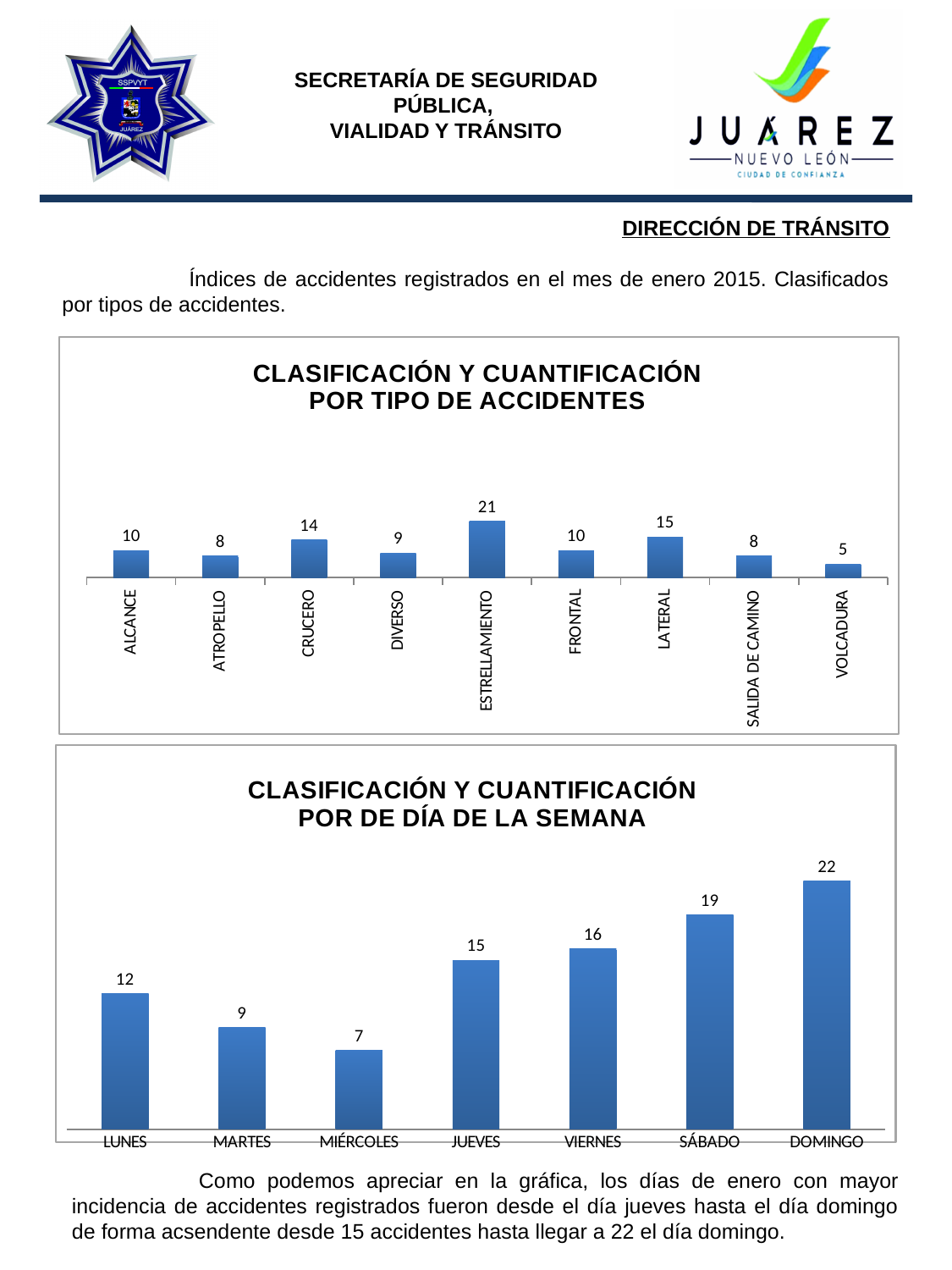
In the chart 'CLASIFICACIÓN Y CUANTIFICACIÓN POR DE DÍA DE LA SEMANA', do the values rise or fall from JUEVES to DOMINGO? rise What kind of chart is 'CLASIFICACIÓN Y CUANTIFICACIÓN POR DE DÍA DE LA SEMANA'? bar chart In the chart 'CLASIFICACIÓN Y CUANTIFICACIÓN POR DE DÍA DE LA SEMANA', what is the difference between DOMINGO and LUNES? 10 In the chart 'CLASIFICACIÓN Y CUANTIFICACIÓN POR TIPO DE ACCIDENTES', which category has the highest value? ESTRELLAMIENTO In the chart 'CLASIFICACIÓN Y CUANTIFICACIÓN POR TIPO DE ACCIDENTES', what is the difference between LATERAL and CRUCERO? 1 In the chart 'CLASIFICACIÓN Y CUANTIFICACIÓN POR TIPO DE ACCIDENTES', what is the value for ESTRELLAMIENTO? 21 In the chart 'CLASIFICACIÓN Y CUANTIFICACIÓN POR TIPO DE ACCIDENTES', which category has the lowest value? VOLCADURA In the chart 'CLASIFICACIÓN Y CUANTIFICACIÓN POR DE DÍA DE LA SEMANA', what is the value for SÁBADO? 19 In the chart 'CLASIFICACIÓN Y CUANTIFICACIÓN POR DE DÍA DE LA SEMANA', which day has the highest value? DOMINGO In the chart 'CLASIFICACIÓN Y CUANTIFICACIÓN POR TIPO DE ACCIDENTES', how many categories are shown? 9 In the chart 'CLASIFICACIÓN Y CUANTIFICACIÓN POR TIPO DE ACCIDENTES', which is larger, FRONTAL or DIVERSO? FRONTAL In the chart 'CLASIFICACIÓN Y CUANTIFICACIÓN POR DE DÍA DE LA SEMANA', which day has the lowest value? MIÉRCOLES